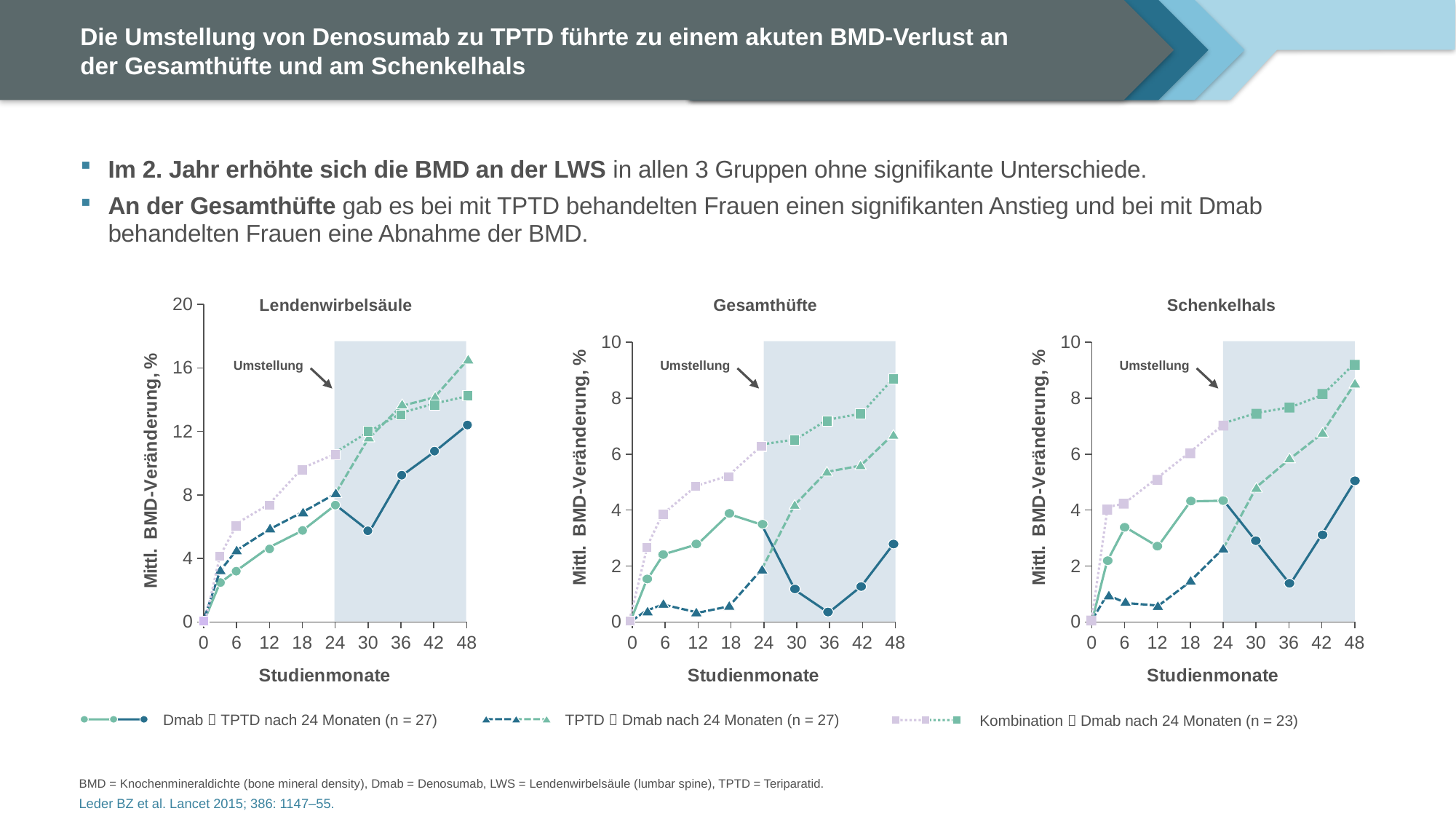
How many series does the legend list for the charts? 3 In the Gesamthüfte chart, is the value for Dmab → TPTD at 36 months greater or less than 2? less In the Gesamthüfte chart, does the Dmab → TPTD series rise or fall between 24 and 36 months? fall In the Schenkelhals chart, is the value for Kombination → Dmab at 48 months greater or less than 8? greater How many charts are shown on the slide? 3 In the Lendenwirbelsäule chart, which series has the highest value at 48 months? TPTD → Dmab nach 24 Monaten (n = 27) In the Gesamthüfte chart, which series has the highest value at 48 months? Kombination → Dmab nach 24 Monaten (n = 23) In the Gesamthüfte chart, which series has the lowest value at 48 months? Dmab → TPTD nach 24 Monaten (n = 27) What kind of chart is the Lendenwirbelsäule chart? Line chart In the Lendenwirbelsäule chart, is the value for Dmab → TPTD at 30 months greater or less than 8? less In the Gesamthüfte chart, at 48 months, which is larger: TPTD → Dmab or Dmab → TPTD? TPTD → Dmab What is the y-axis label of the Schenkelhals chart? Mittl. BMD-Veränderung, %